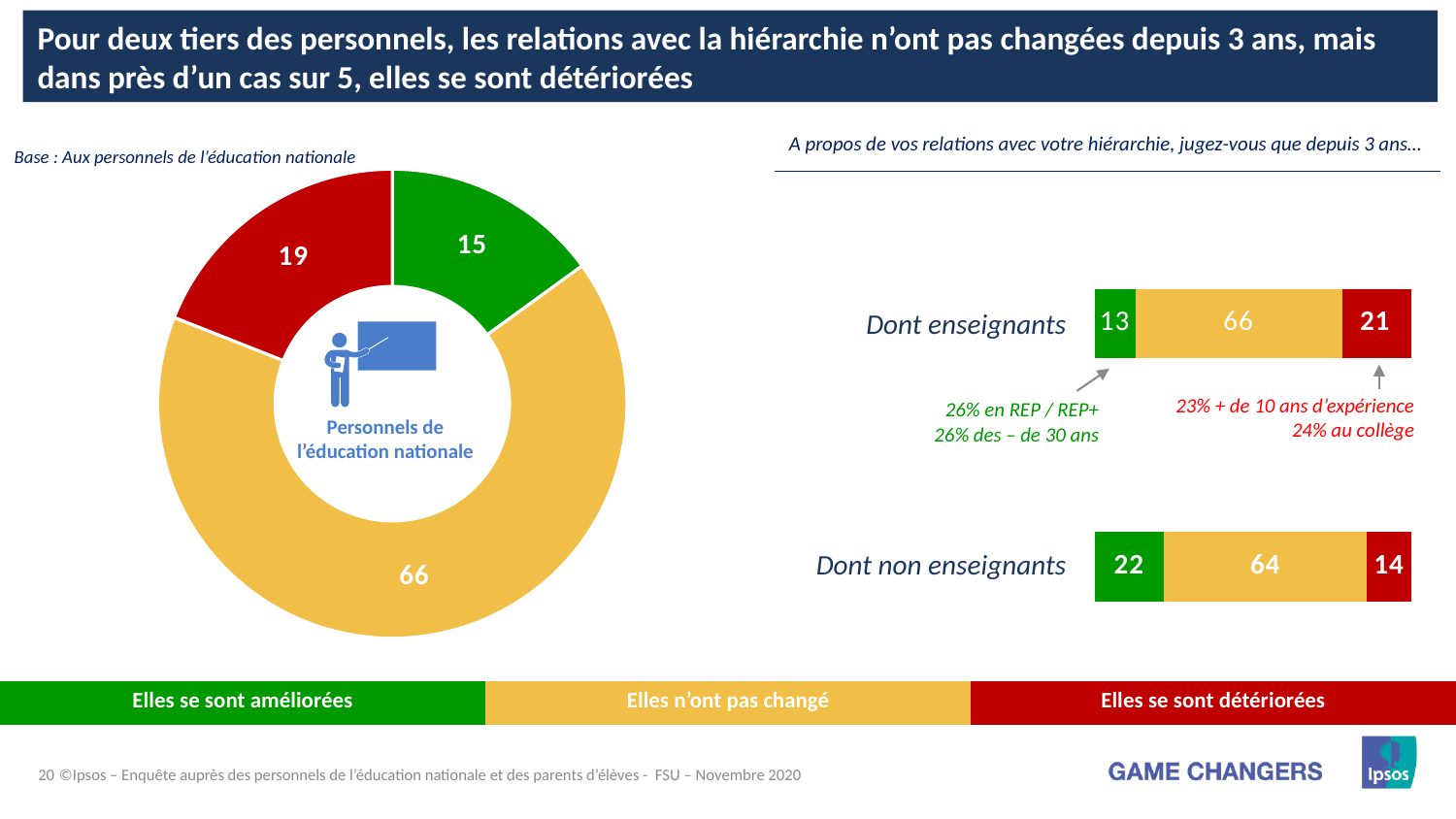
How many series does the legend at the bottom of the slide list? 3 In the 'Dont enseignants' bar, what is the value for 'Elles se sont améliorées'? 13 What is the total of the 'Dont non enseignants' stacked bar? 100 Which is larger: 'Elles se sont améliorées' for 'Dont enseignants' or for 'Dont non enseignants'? Dont non enseignants In the donut chart for 'Personnels de l'éducation nationale', what is the difference between 'Elles se sont détériorées' and 'Elles se sont améliorées'? 4 In the donut chart for 'Personnels de l'éducation nationale', what is the value for 'Elles se sont détériorées'? 19 What kind of chart is used for 'Personnels de l'éducation nationale'? Donut (pie) chart In the donut chart for 'Personnels de l'éducation nationale', what is the value for 'Elles n'ont pas changé'? 66 In the 'Dont non enseignants' bar, what is the value for 'Elles n'ont pas changé'? 64 In the donut chart for 'Personnels de l'éducation nationale', which category has the smallest share? Elles se sont améliorées Which colour represents 'Elles se sont détériorées' in the charts? Red In the 'Dont enseignants' bar, what is the value for 'Elles se sont détériorées'? 21